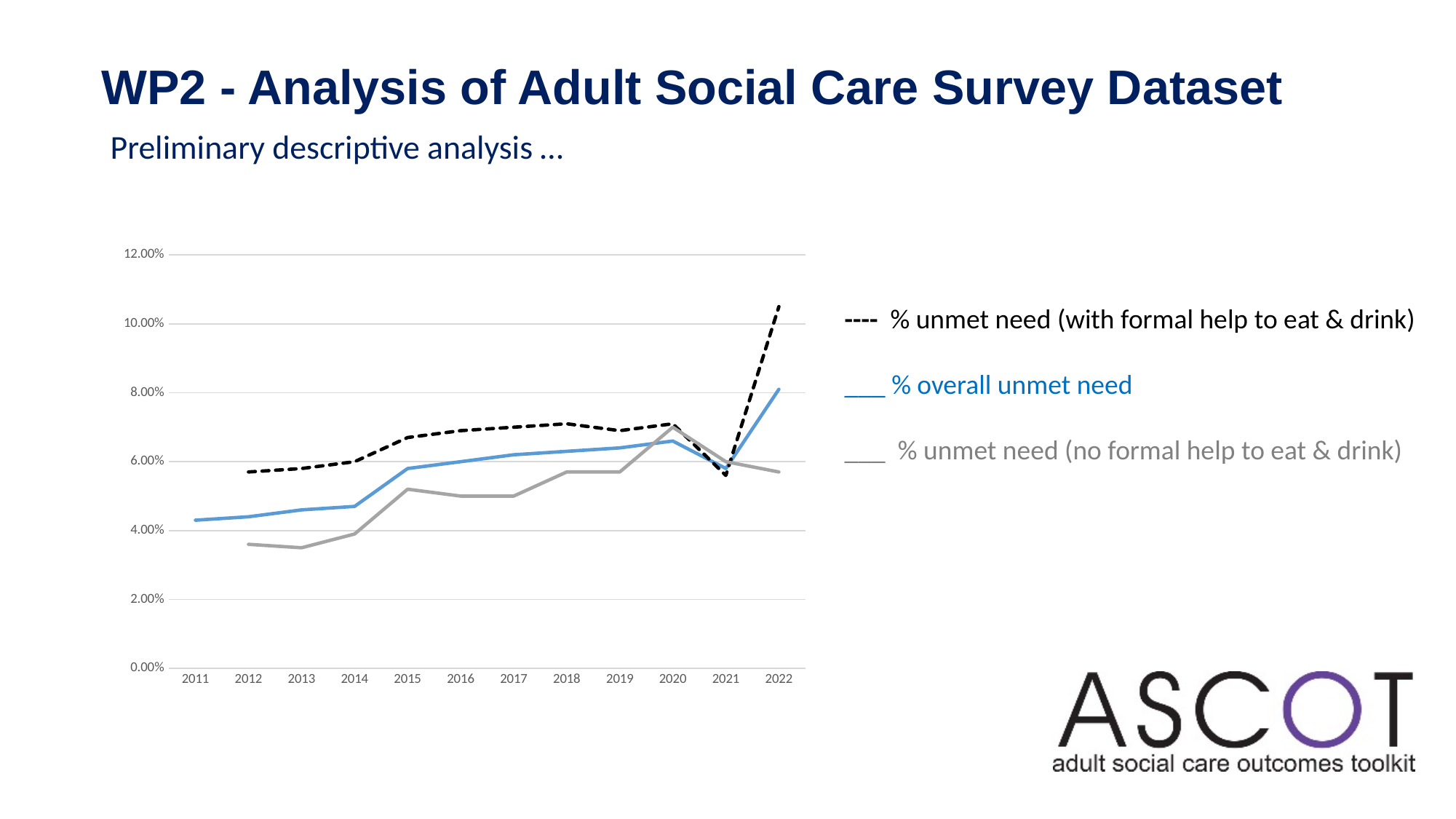
In which year is % overall unmet need lowest? 2011 Is the value for % overall unmet need in 2011 greater or less than 6.00%? less In 2015, which is larger: % unmet need (with formal help to eat & drink) or % unmet need (no formal help to eat & drink)? % unmet need (with formal help to eat & drink) How many series does the legend list? 3 Is the value for % unmet need (no formal help to eat & drink) in 2013 greater or less than 4.00%? less In which year is % overall unmet need highest? 2022 What kind of chart is shown on the slide? line chart How many years are shown on the x axis? 12 In which year is % unmet need (no formal help to eat & drink) highest? 2020 Is the value for % unmet need (with formal help to eat & drink) in 2022 greater or less than 10.00%? greater Which series is drawn with a dashed line? % unmet need (with formal help to eat & drink)